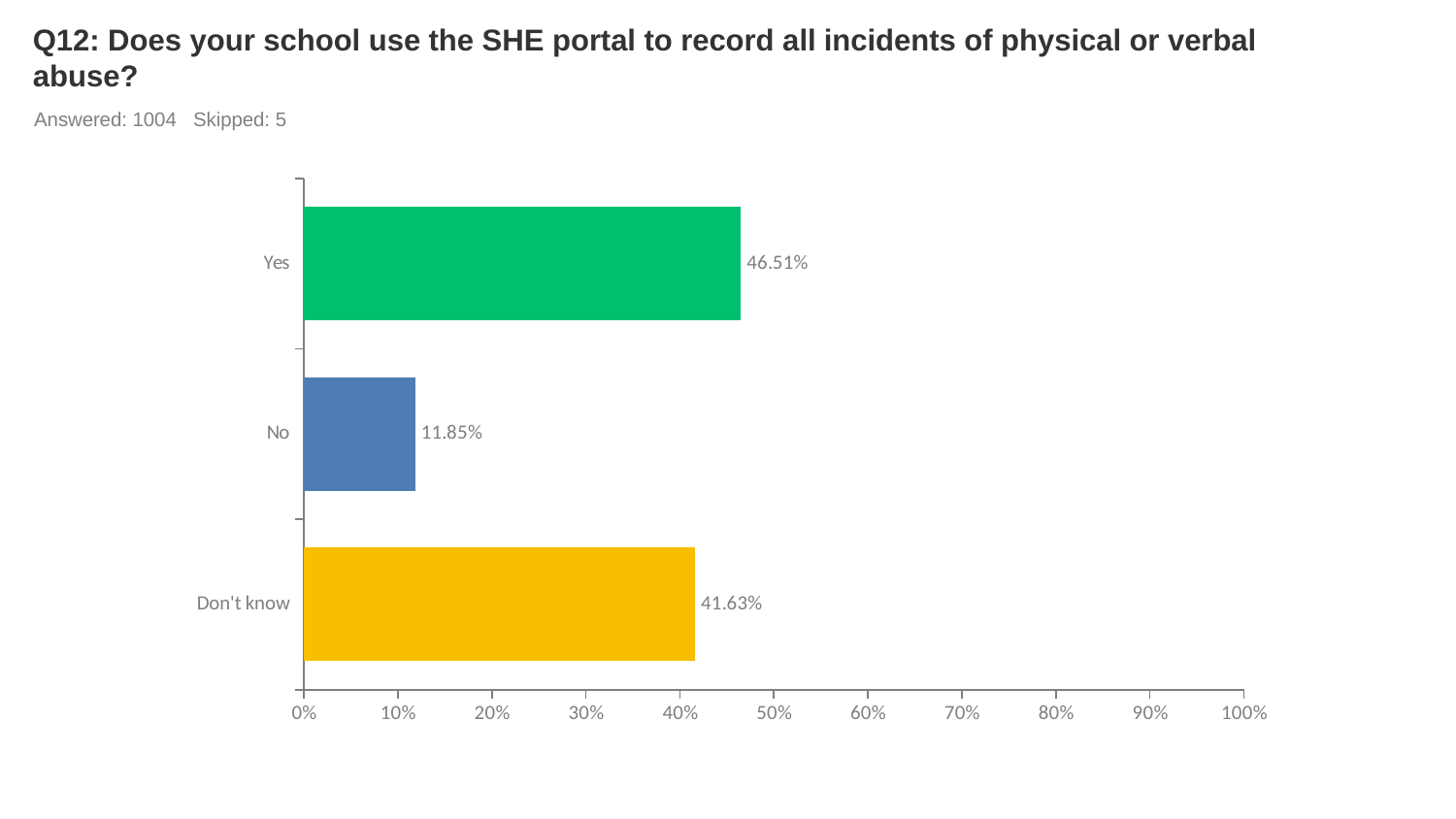
Which response has the lowest percentage? No What is the difference in percentage points between "Yes" and "No"? 34.66 How many respondents answered this question? 1004 What percentage of respondents answered "No"? 11.85% What kind of chart is shown on the slide? Bar chart How many response categories are shown in the chart? 3 Which is larger, the percentage for "No" or for "Don't know"? Don't know What is the difference in percentage points between "Yes" and "Don't know"? 4.88 Which response has the highest percentage? Yes What percentage of respondents answered "Yes"? 46.51% Is the value for "Don't know" greater or less than 50%? less What percentage of respondents answered "Don't know"? 41.63%